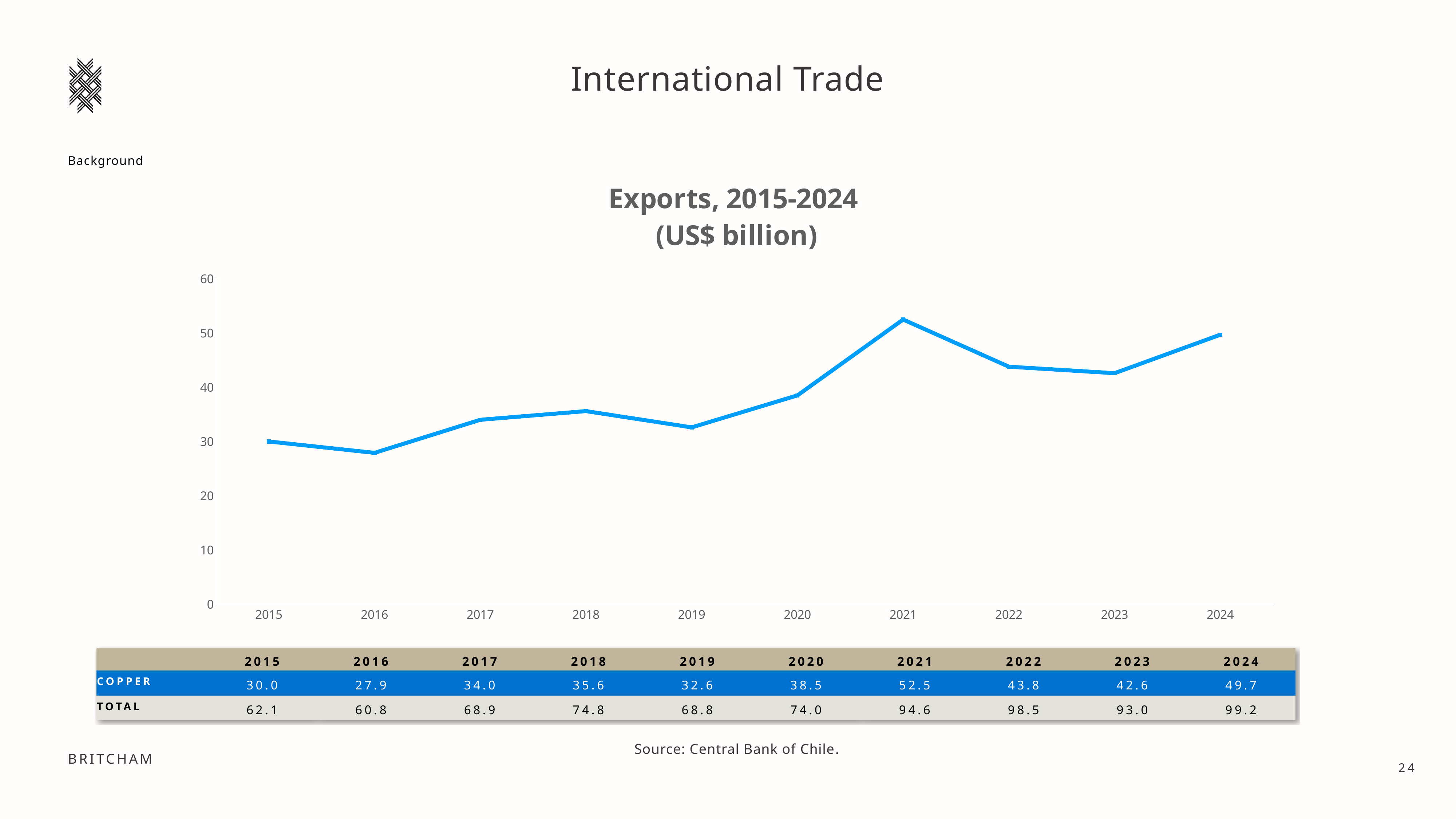
What is the difference between copper exports in 2021 and 2020? 14.0 What type of chart is shown on the slide? line chart Which year had higher copper exports, 2018 or 2019? 2018 What is the total export value for 2024 shown in the data table? 99.2 Is the copper export value for 2024 greater or less than 40? greater In which year were copper exports highest? 2021 What is the copper export value for 2016? 27.9 What is the copper export value for 2021? 52.5 In which year were copper exports lowest? 2016 What is the title of the chart? Exports, 2015-2024 (US$ billion) Did copper exports rise or fall from 2021 to 2023? fall How many years are plotted on the x axis? 10